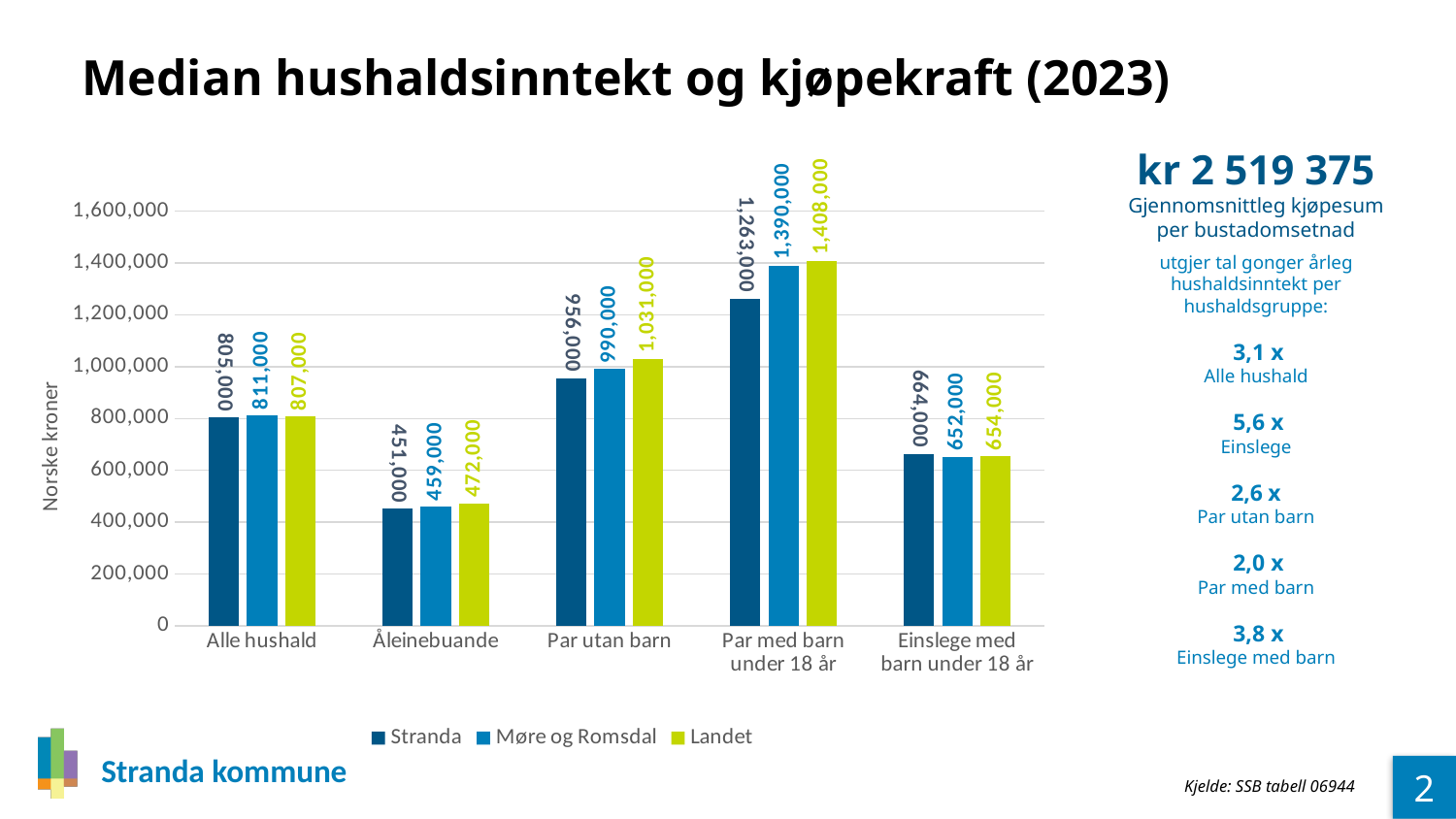
Which category has the lowest value for Stranda? Åleinebuande What is the value for Stranda in the Par med barn under 18 år category? 1,263,000 How many series does the legend list? 3 What is the value for Landet in the Åleinebuande category? 472,000 Which category has the highest value for Landet? Par med barn under 18 år In the Einslege med barn under 18 år category, which is larger: Stranda or Møre og Romsdal? Stranda What is the label of the vertical axis? Norske kroner What is the value for Møre og Romsdal in the Par utan barn category? 990,000 What is the difference between the Landet and Stranda values in the Par utan barn category? 75,000 Is the value for Møre og Romsdal in the Par med barn under 18 år category greater or less than 1,200,000? greater What kind of chart is shown on the slide? Bar chart How many household categories are shown on the x axis? 5